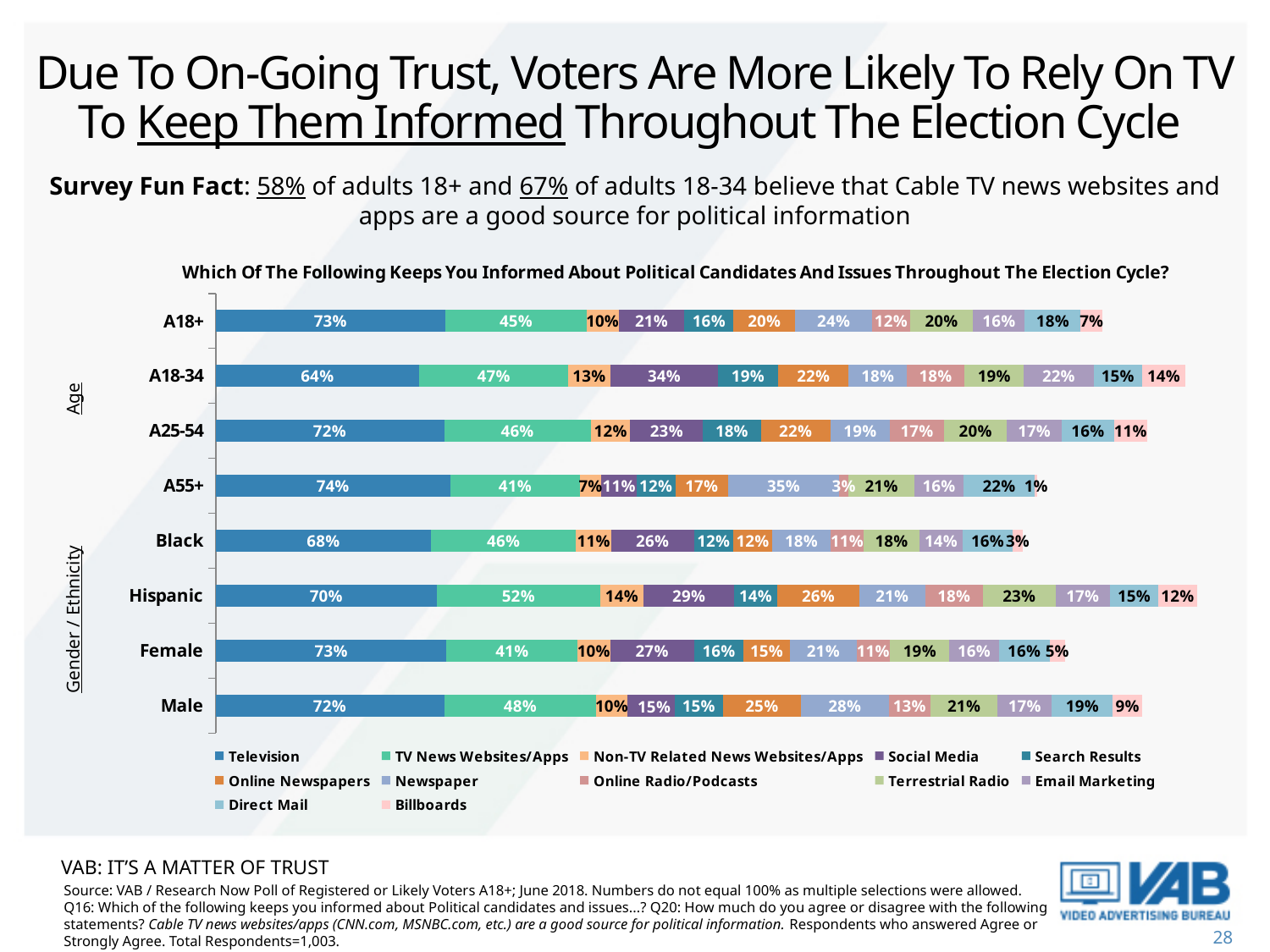
Which is larger, the Social Media value for Female or for Male? Female Which series is shown in the first (leftmost) segment of each bar? Television What type of chart is shown on the slide? Stacked bar chart What is the Social Media value for the A18-34 group? 34% How many series does the legend list? 12 What is the difference between the Television values for A55+ and A18-34? 10% How many groups (bars) are shown in the chart? 8 Which group has the lowest Television value? A18-34 Which group has the highest Television value? A55+ What is the Newspaper value for the A55+ group? 35% What is the TV News Websites/Apps value for Hispanic respondents? 52% What percentage of A18+ respondents say Television keeps them informed? 73%